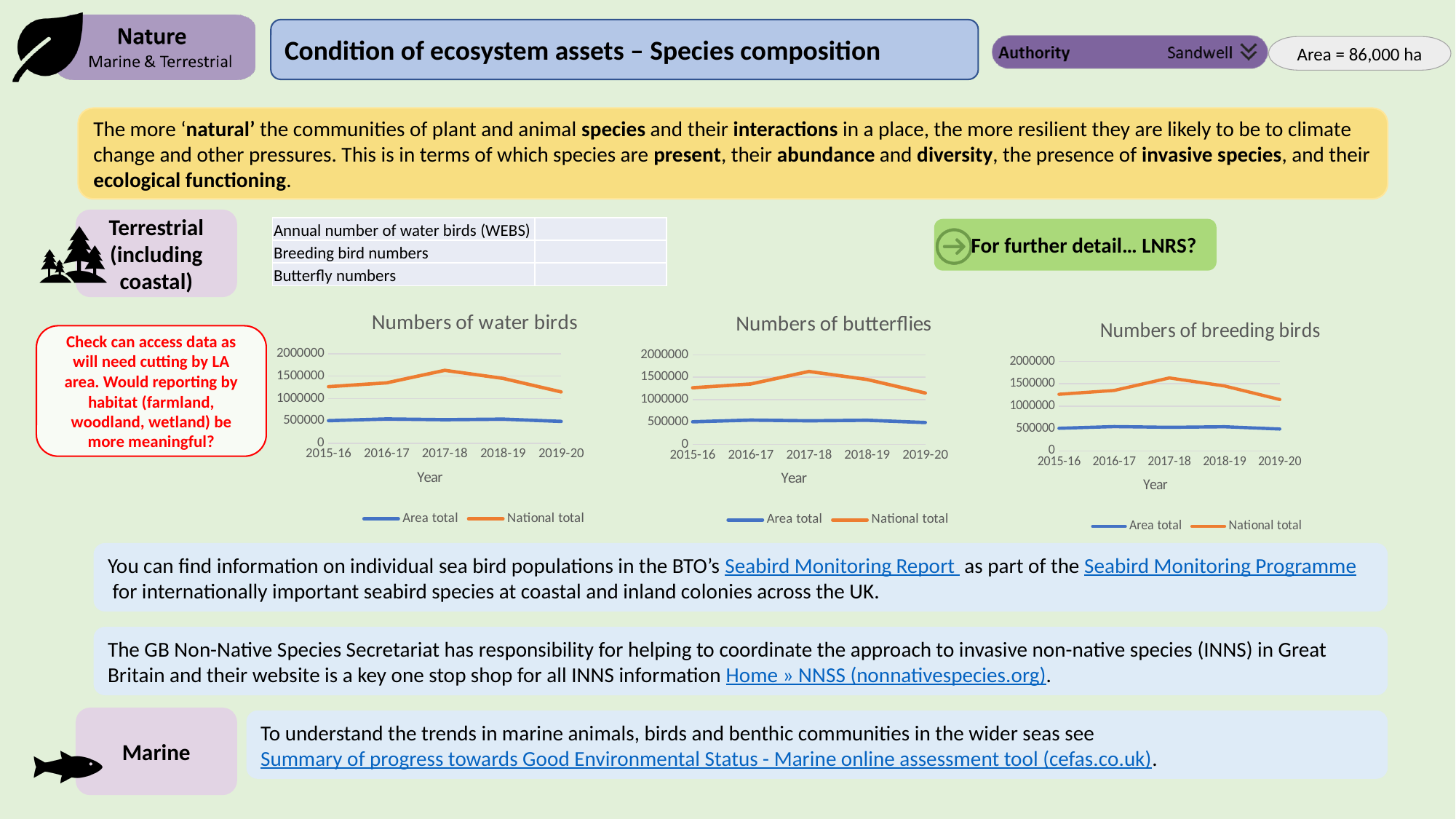
In the 'Numbers of water birds' chart, which series is larger in 2015-16, Area total or National total? National total What is the x-axis title of the 'Numbers of butterflies' chart? Year How many series does the legend of the 'Numbers of butterflies' chart list? 2 In the 'Numbers of water birds' chart, which year has the highest National total? 2017-18 How many years are shown on the x axis of the 'Numbers of breeding birds' chart? 5 In the 'Numbers of butterflies' chart, is the National total for 2017-18 greater or less than 1500000? greater In the 'Numbers of breeding birds' chart, is the Area total for 2019-20 greater or less than 1000000? less In the 'Numbers of butterflies' chart, does the National total rise or fall from 2017-18 to 2019-20? fall What kind of chart is the 'Numbers of water birds' chart? line chart In the 'Numbers of breeding birds' chart, which year has the highest National total? 2017-18 In the 'Numbers of breeding birds' chart, what colour is the National total line? orange In the 'Numbers of water birds' chart, is the National total for 2019-20 greater or less than 1000000? greater